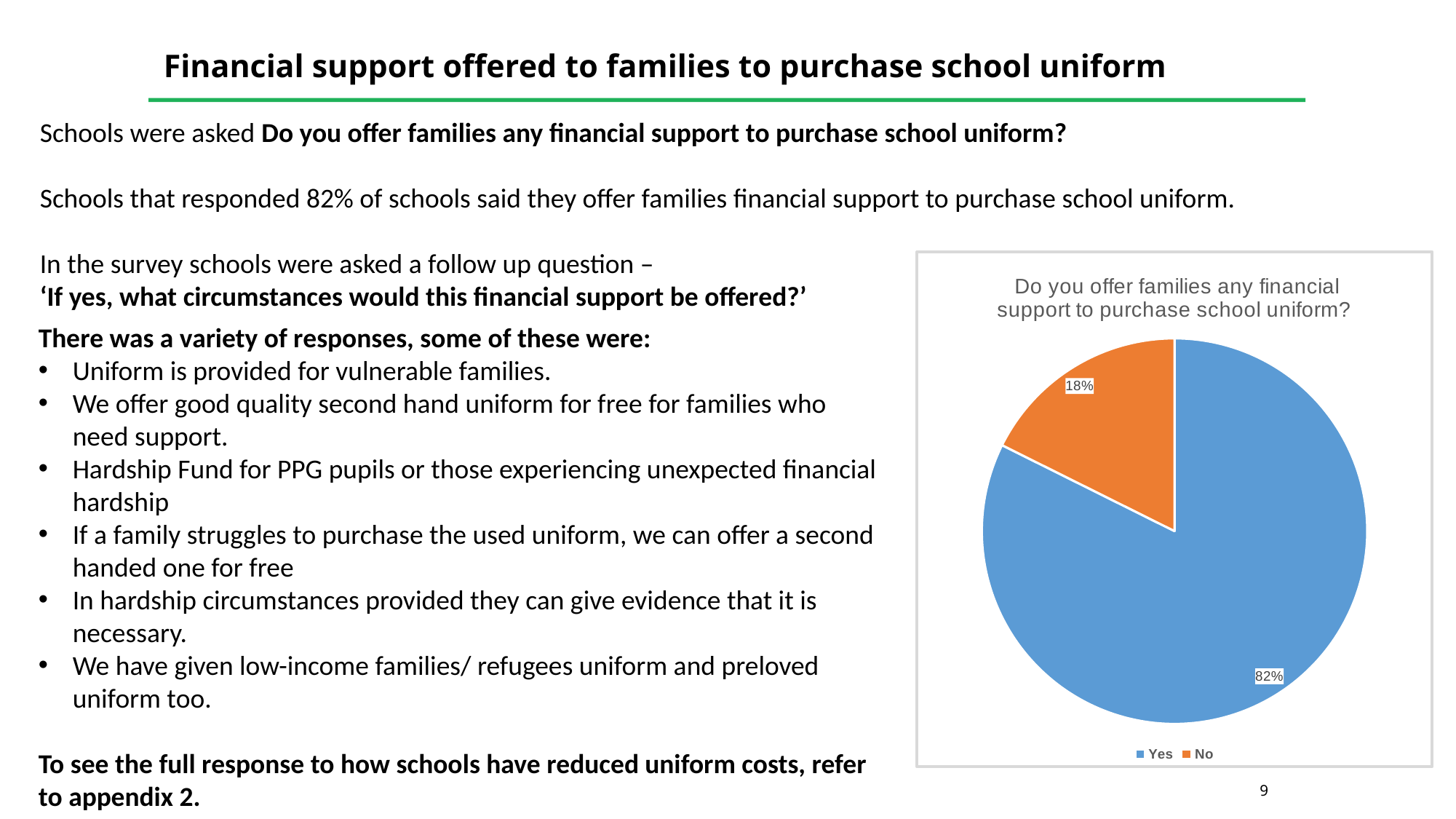
What percentage of schools answered No in the pie chart? 18% What percentage of schools answered Yes in the pie chart? 82% What colour is the Yes slice in the pie chart? Blue How many slices does the pie chart have? 2 Which slice is larger, Yes or No? Yes What is the difference in percentage points between the Yes and No slices? 64 Which response has the smallest share of the pie chart? No How many entries does the chart legend list? 2 What share of the pie does the No slice represent? 18% What type of chart is shown on the slide? Pie chart Which response has the largest share of the pie chart? Yes What is the title of the pie chart? Do you offer families any financial support to purchase school uniform?